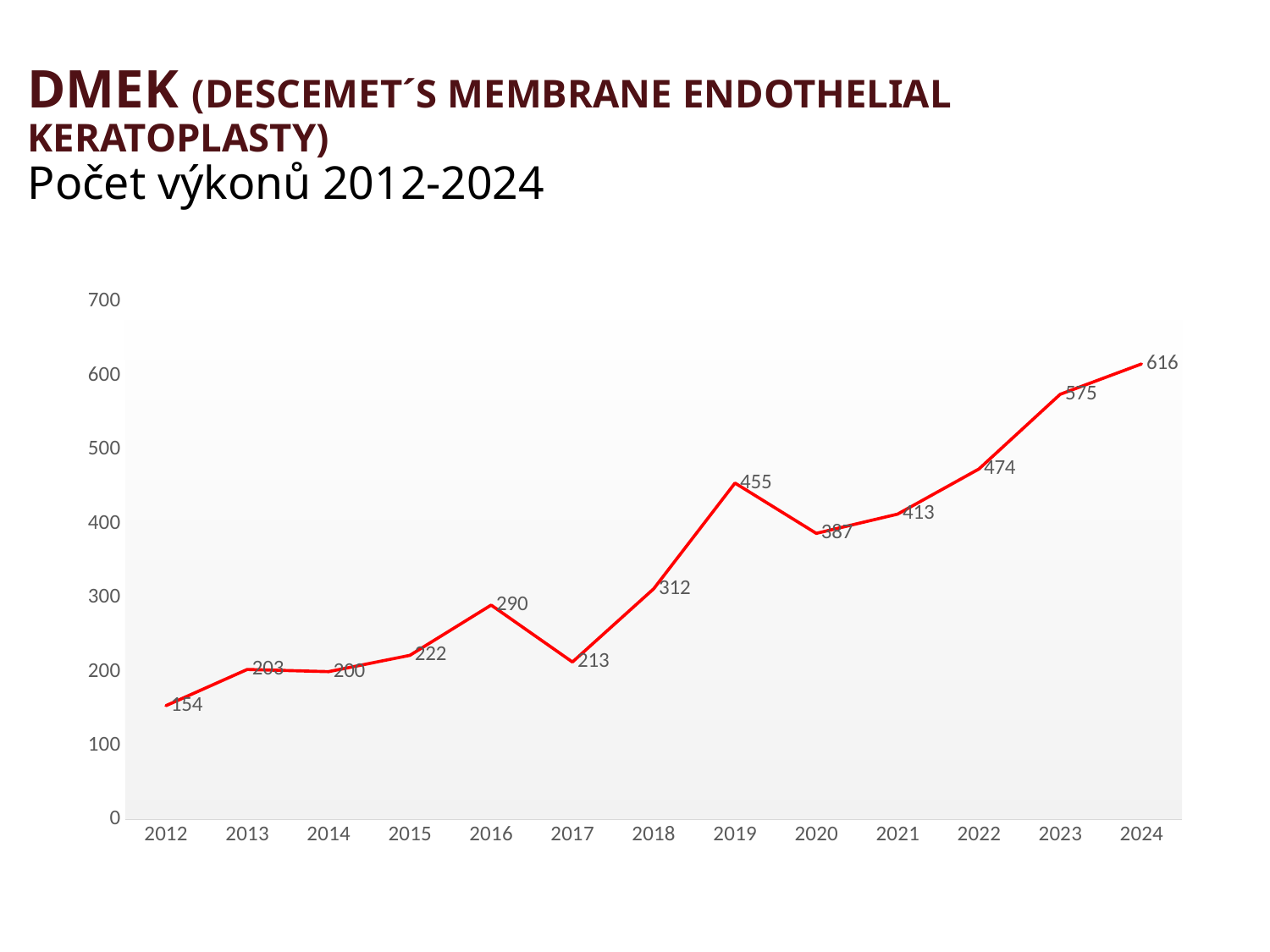
Which year had the highest number of procedures? 2024 What is the difference between the number of procedures in 2019 and in 2020? 68 Which year had the lowest number of procedures? 2012 How many years are plotted on the chart? 13 What is the difference between the number of procedures in 2024 and in 2023? 41 Which year had more procedures, 2016 or 2017? 2016 Is the value for 2022 greater or less than 500? less What was the number of DMEK procedures in 2012? 154 What type of chart is shown on the slide? line chart What is the overall trend of the number of procedures from 2012 to 2024? rising What was the number of DMEK procedures in 2024? 616 What was the number of DMEK procedures in 2019? 455